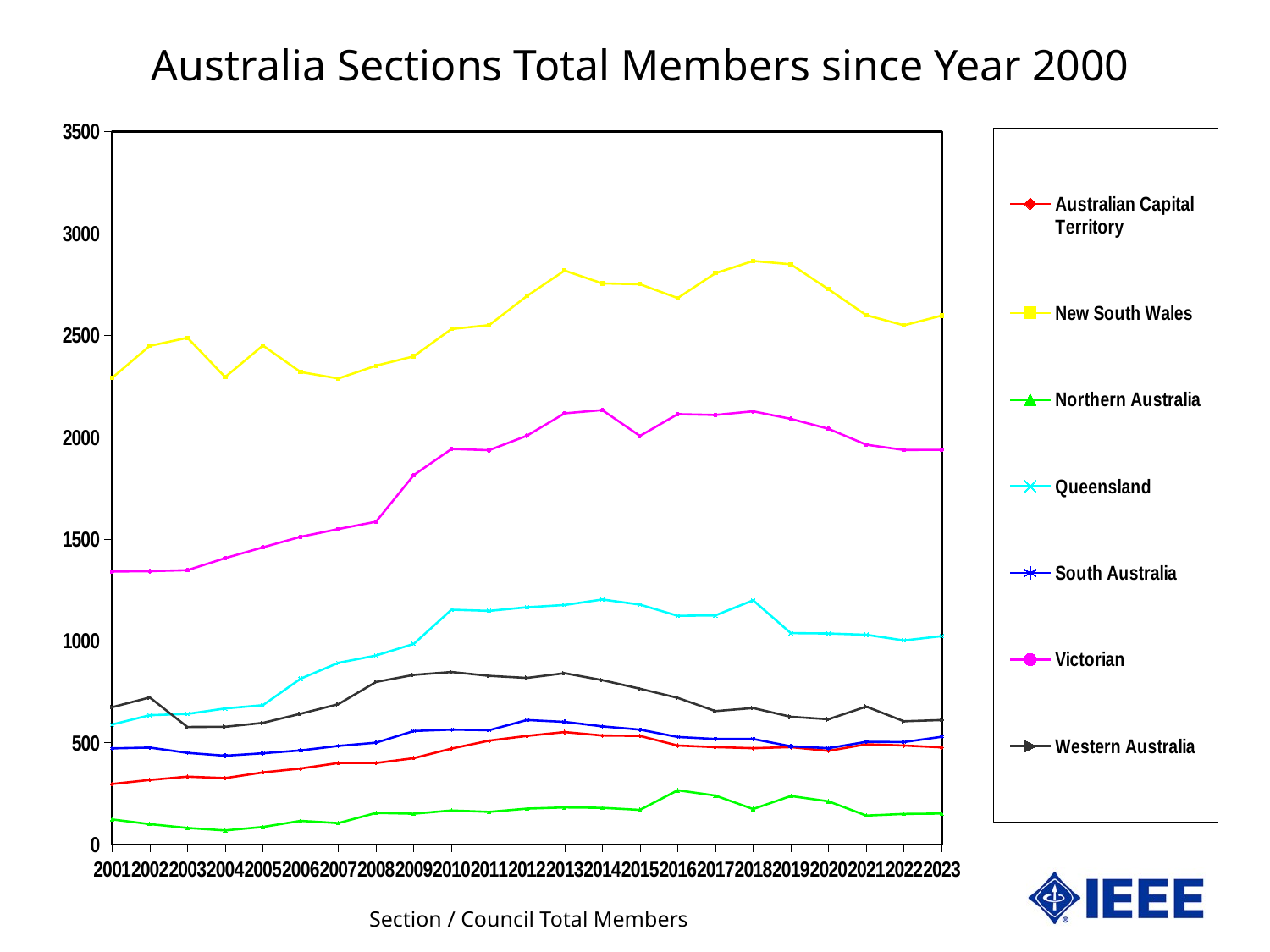
Is the value for Australian Capital Territory in 2001 greater or less than 500? less How many years are plotted along the x axis? 23 Do the values for Victorian rise or fall from 2001 to 2013? rise Which is larger in 2023, the value for Queensland or the value for Western Australia? Queensland What kind of chart is shown on the slide? line chart What is the title of the chart? Australia Sections Total Members since Year 2000 How many series does the legend list? 7 Which section has the lowest total members in 2023? Northern Australia Which section has the highest total members in 2023? New South Wales Is the value for Victorian in 2001 greater or less than 1500? less Is the value for New South Wales in 2018 greater or less than 2500? greater